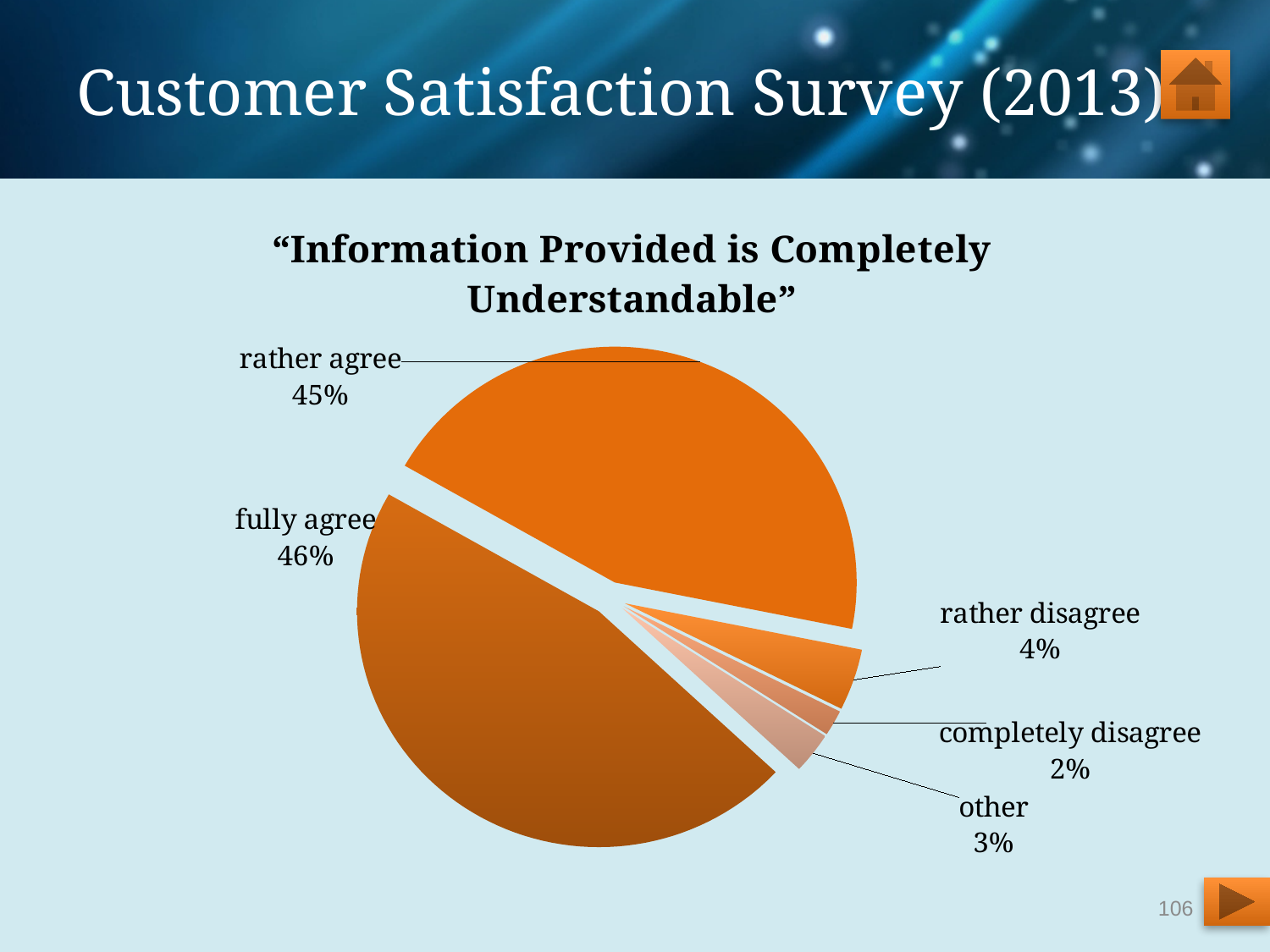
What is the chart's title? "Information Provided is Completely Understandable" What is the difference in percentage points between "fully agree" and "rather agree"? 1 What percentage of respondents chose "rather agree"? 45% What percentage of respondents chose "other"? 3% What percentage of respondents chose "rather disagree"? 4% Which response has the largest share of the pie? fully agree What percentage of respondents chose "fully agree"? 46% What kind of chart is shown on the slide? pie chart Which response has the smallest share of the pie? completely disagree What percentage of respondents chose "completely disagree"? 2% How many slices does the pie chart have? 5 Which is larger, the share for "rather disagree" or the share for "other"? rather disagree